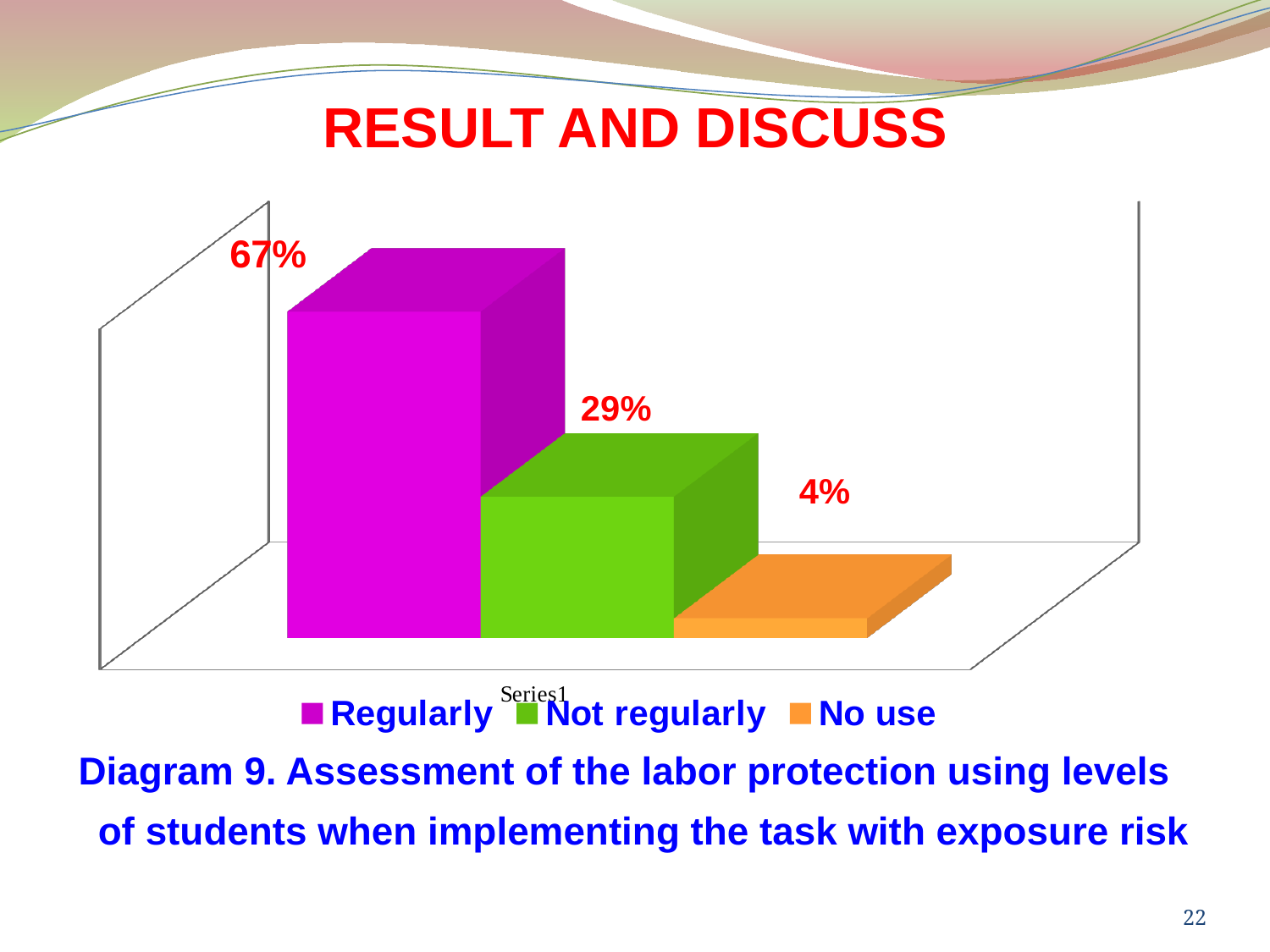
What is the value for No use? 4% What is the difference between the values for Regularly and Not regularly? 38% What kind of chart is shown on the slide? Bar chart Which category has the lowest value? No use What colour is the bar for No use? Orange Which is larger, the value for Not regularly or the value for No use? Not regularly How many categories are shown in the chart? 3 What is the value for Not regularly? 29% What is the value for Regularly? 67% Which category has the highest value? Regularly What is the difference between the values for Not regularly and No use? 25% Do the values rise or fall from left to right across the bars? Fall